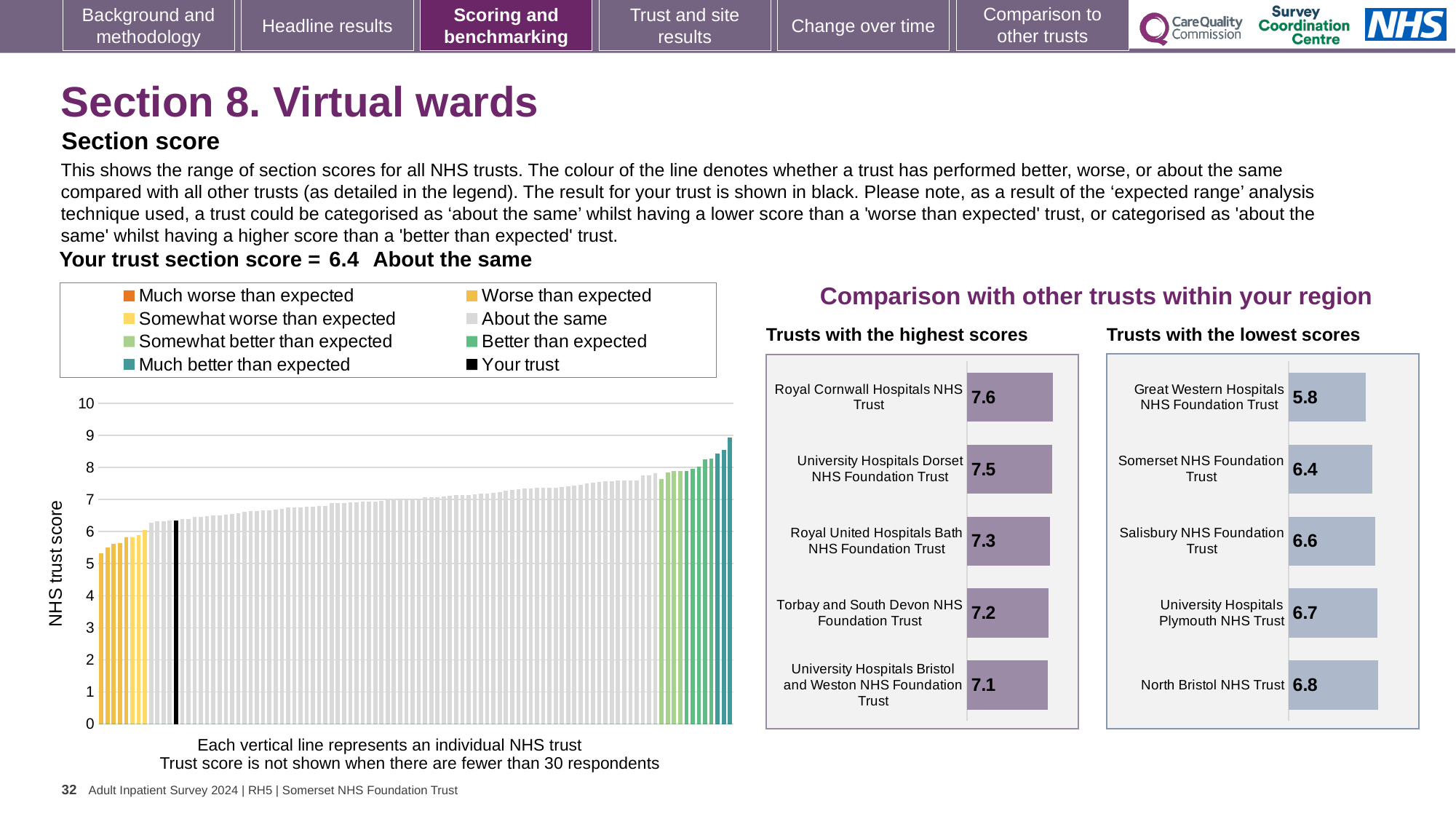
How many entries does the legend of the main NHS trust score chart on the left list? 8 In the 'Trusts with the highest scores' chart, what is the score for Torbay and South Devon NHS Foundation Trust? 7.2 In the 'Trusts with the lowest scores' chart, what is the difference between the scores of North Bristol NHS Trust and Great Western Hospitals NHS Foundation Trust? 1.0 What kind of chart is the main NHS trust score chart on the left? Bar chart In the main NHS trust score chart on the left, is the value of the tallest bar greater or less than 8? greater In the 'Trusts with the highest scores' chart, what is the score for Royal Cornwall Hospitals NHS Trust? 7.6 In the 'Trusts with the lowest scores' chart, which has the higher score: Somerset NHS Foundation Trust or Salisbury NHS Foundation Trust? Salisbury NHS Foundation Trust How many trusts are shown in the 'Trusts with the lowest scores' chart? 5 In the 'Trusts with the lowest scores' chart, what is the score for Great Western Hospitals NHS Foundation Trust? 5.8 In the 'Trusts with the lowest scores' chart, which trust has the lowest score? Great Western Hospitals NHS Foundation Trust In the 'Trusts with the highest scores' chart, what is the difference between the scores of Royal Cornwall Hospitals NHS Trust and University Hospitals Bristol and Weston NHS Foundation Trust? 0.5 In the 'Trusts with the highest scores' chart, which trust has the highest score? Royal Cornwall Hospitals NHS Trust